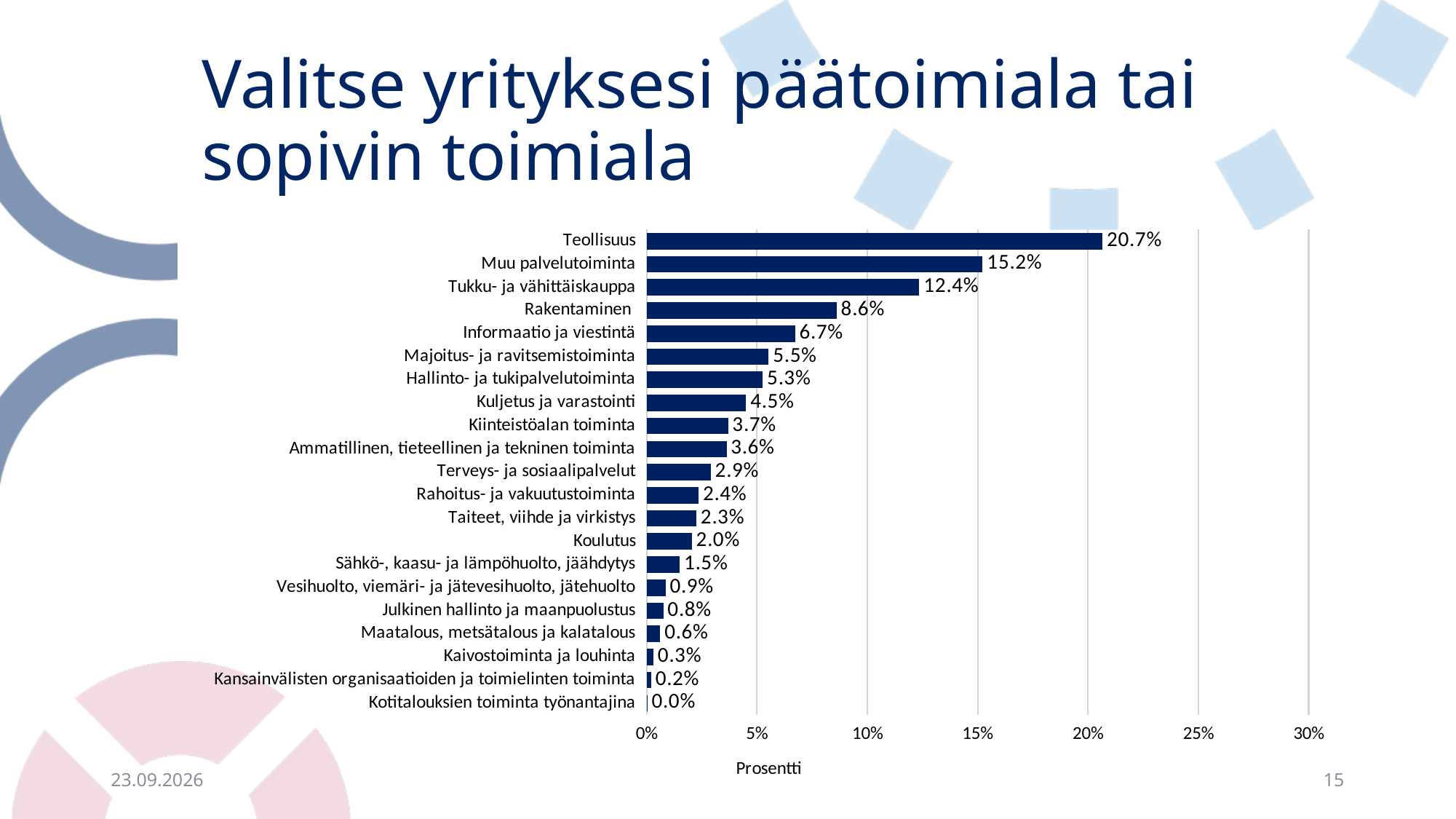
Which category has the highest value? Teollisuus What is the value for Kaivostoiminta ja louhinta? 0.3% Which is larger, the value for Tukku- ja vähittäiskauppa or the value for Rakentaminen? Tukku- ja vähittäiskauppa What is the value for Koulutus? 2.0% What is the difference between the values for Teollisuus and Muu palvelutoiminta? 5.5 percentage points What is the value for Teollisuus? 20.7% Is the value for Muu palvelutoiminta greater or less than 10%? greater Which category has the lowest value? Kotitalouksien toiminta työnantajina How many categories are shown in the chart? 21 What kind of chart is shown on the slide? Bar chart What is the value for Rakentaminen? 8.6% What is the label of the horizontal axis? Prosentti